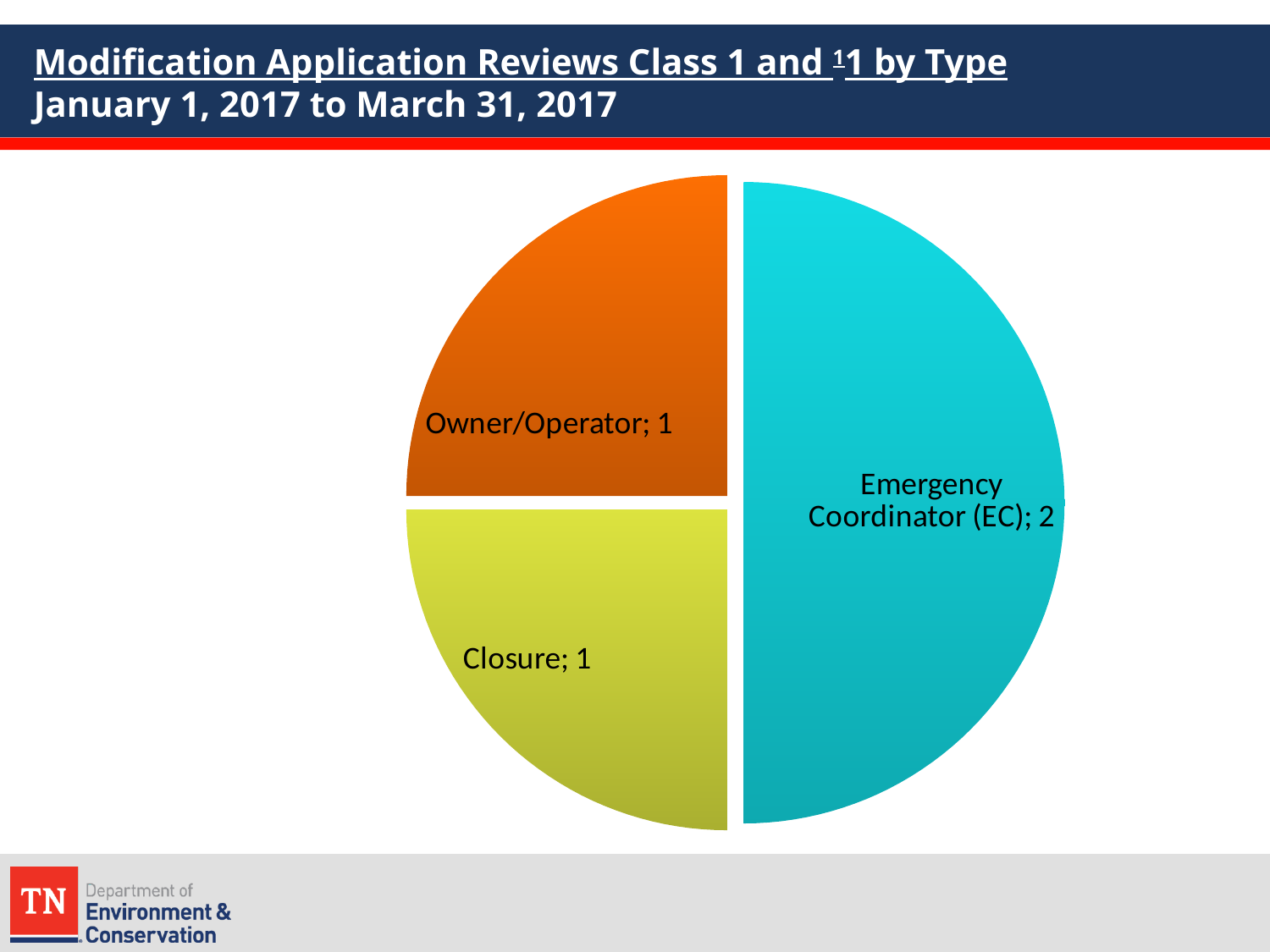
What is the value for Emergency Coordinator (EC)? 2 What is the difference between the Emergency Coordinator (EC) value and the Closure value? 1 What share of the pie does Closure represent? 25% Which category has the largest slice? Emergency Coordinator (EC) What is the value for Closure? 1 Which is larger, the value for Emergency Coordinator (EC) or the value for Owner/Operator? Emergency Coordinator (EC) What is the value for Owner/Operator? 1 How many slices does the pie chart have? 3 What kind of chart is shown on the slide? pie chart What is the total of all slices in the pie chart? 4 What share of the pie does Emergency Coordinator (EC) represent? 50% What date range does the slide title give for the chart? January 1, 2017 to March 31, 2017